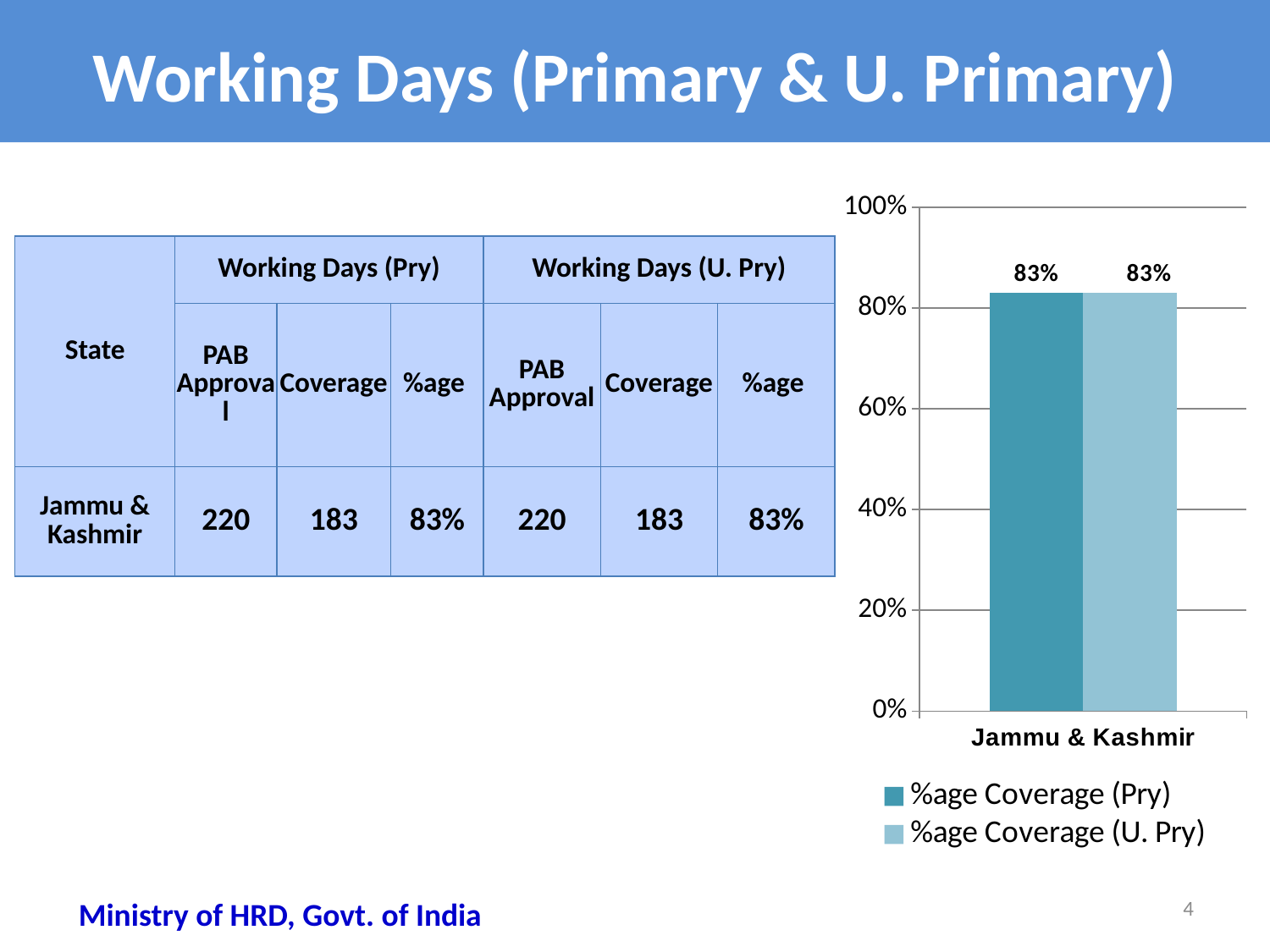
What kind of chart is shown on the slide? bar chart Is the value for %age Coverage (U. Pry) for Jammu & Kashmir greater or less than 100%? less What is the value of %age Coverage (Pry) for Jammu & Kashmir in the chart? 83% What are the two series named in the chart legend? %age Coverage (Pry) and %age Coverage (U. Pry) What is the difference between %age Coverage (Pry) and %age Coverage (U. Pry) for Jammu & Kashmir in the chart? 0% Is the value for %age Coverage (Pry) for Jammu & Kashmir greater or less than 80%? greater What is the value of %age Coverage (U. Pry) for Jammu & Kashmir in the chart? 83% How many series does the chart legend list? 2 How many categories are shown on the x axis of the chart? 1 What is the highest value shown on the chart's y axis? 100% Which category is shown on the x axis of the chart? Jammu & Kashmir